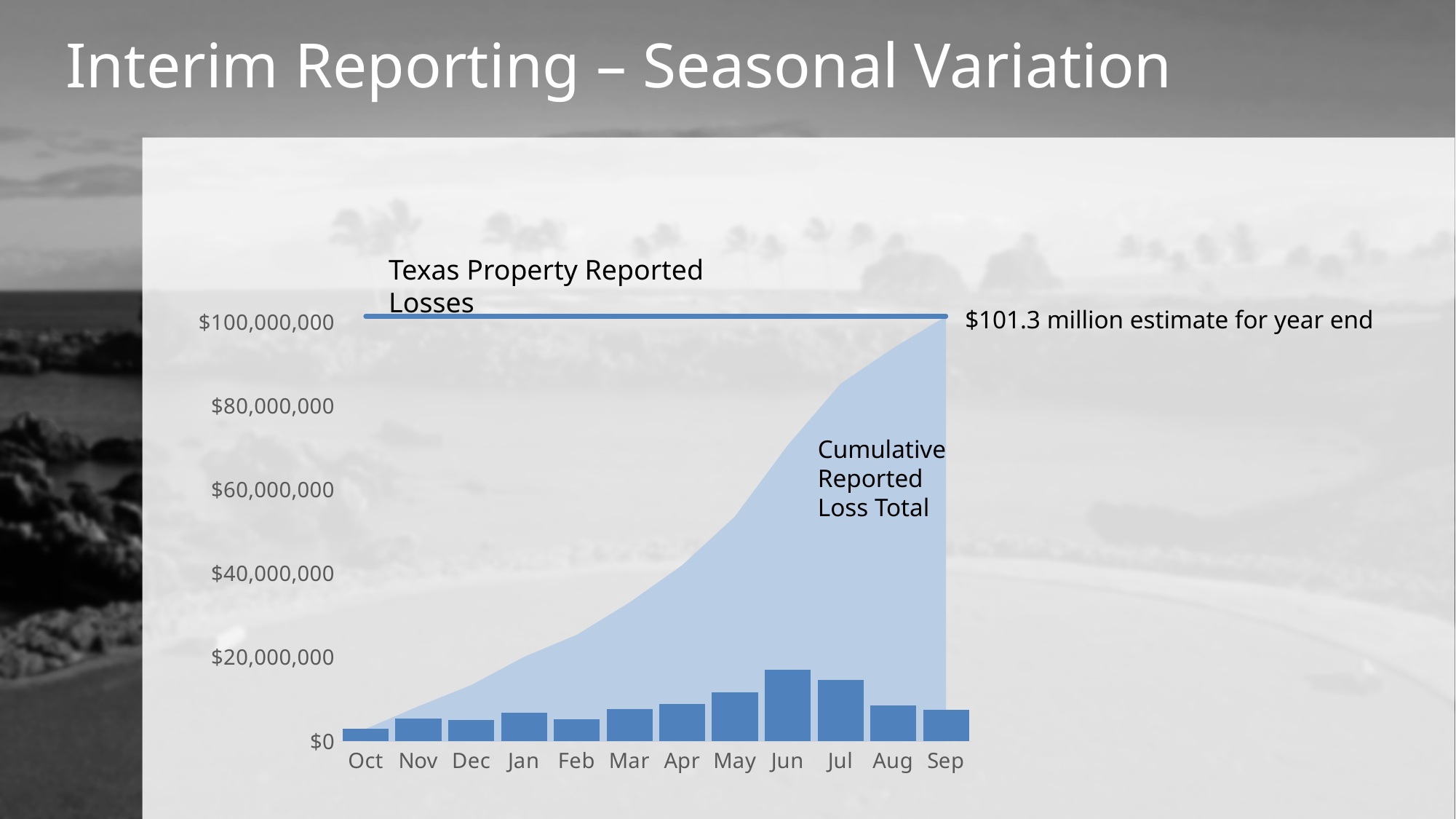
What year-end estimate is annotated on the chart? $101.3 million estimate for year end Which month has the lowest bar for Texas Property Reported Losses? Oct Which month has a larger bar, Jun or Jul? Jun How many months are shown on the x axis of the chart? 12 Is the bar for Jun greater or less than $20,000,000? less Does the Cumulative Reported Loss Total rise or fall from Oct to Sep? rise Is the Cumulative Reported Loss Total at Mar greater or less than $40,000,000? less Is the Cumulative Reported Loss Total at Sep greater or less than $80,000,000? greater Which month has a larger bar, Oct or Nov? Nov Which month has the highest bar for Texas Property Reported Losses? Jun What is the label of the shaded area series on the chart? Cumulative Reported Loss Total